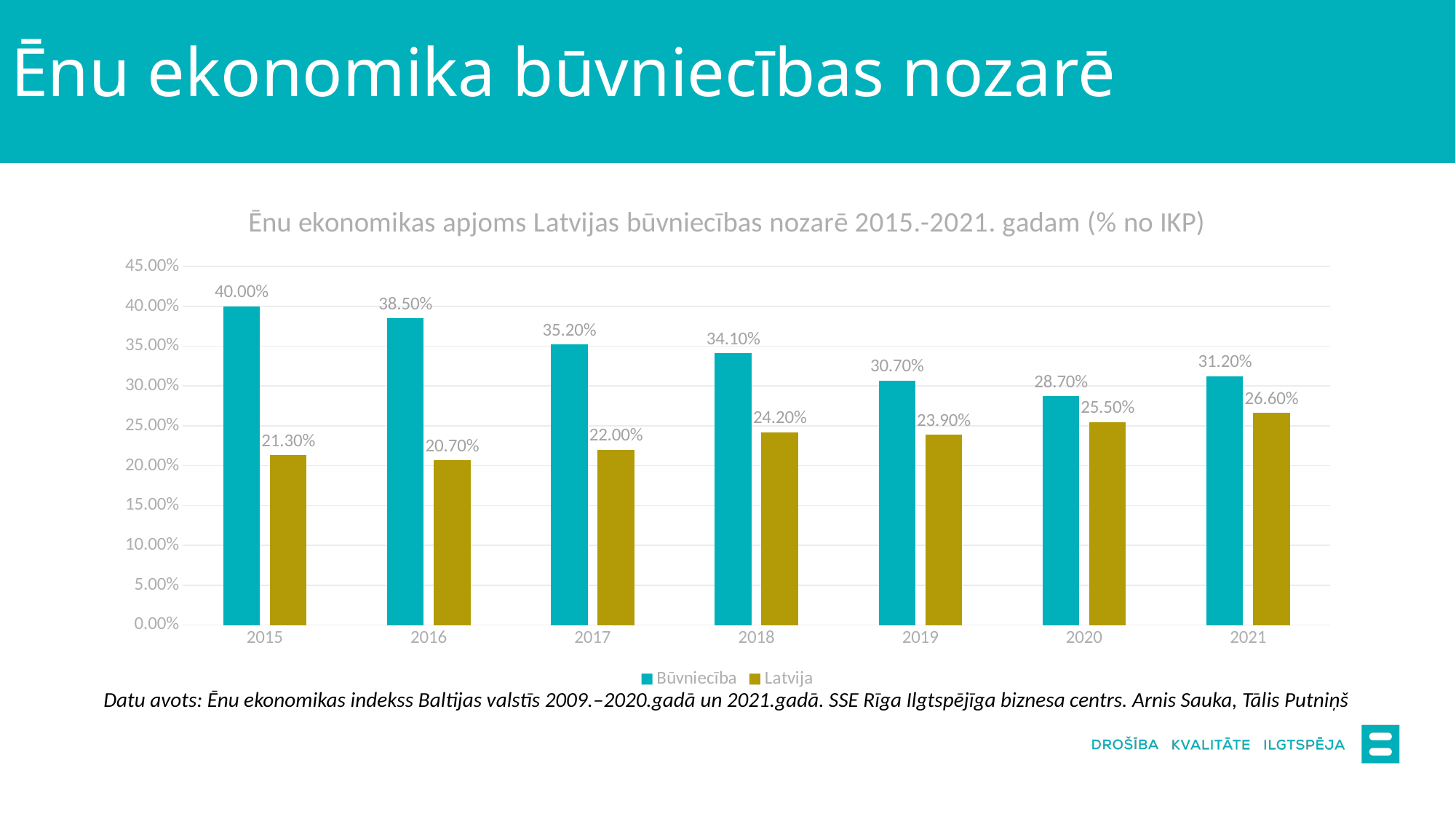
How many series does the legend list? 2 How many years are shown on the x axis? 7 What is the value for Latvija in 2018? 24.20% Which year has the lowest value for Latvija? 2016 Does the Būvniecība value rise or fall from 2015 to 2020? Fall What is the difference between the Būvniecība and Latvija values in 2015? 18.70% What is the value for Būvniecība in 2021? 31.20% What is the title of the chart? Ēnu ekonomikas apjoms Latvijas būvniecības nozarē 2015.-2021. gadam (% no IKP) Which year has the highest value for Būvniecība? 2015 What kind of chart is shown on the slide? Bar chart Which is larger in 2020: the Būvniecība value or the Latvija value? Būvniecība What is the value for Būvniecība in 2015? 40.00%